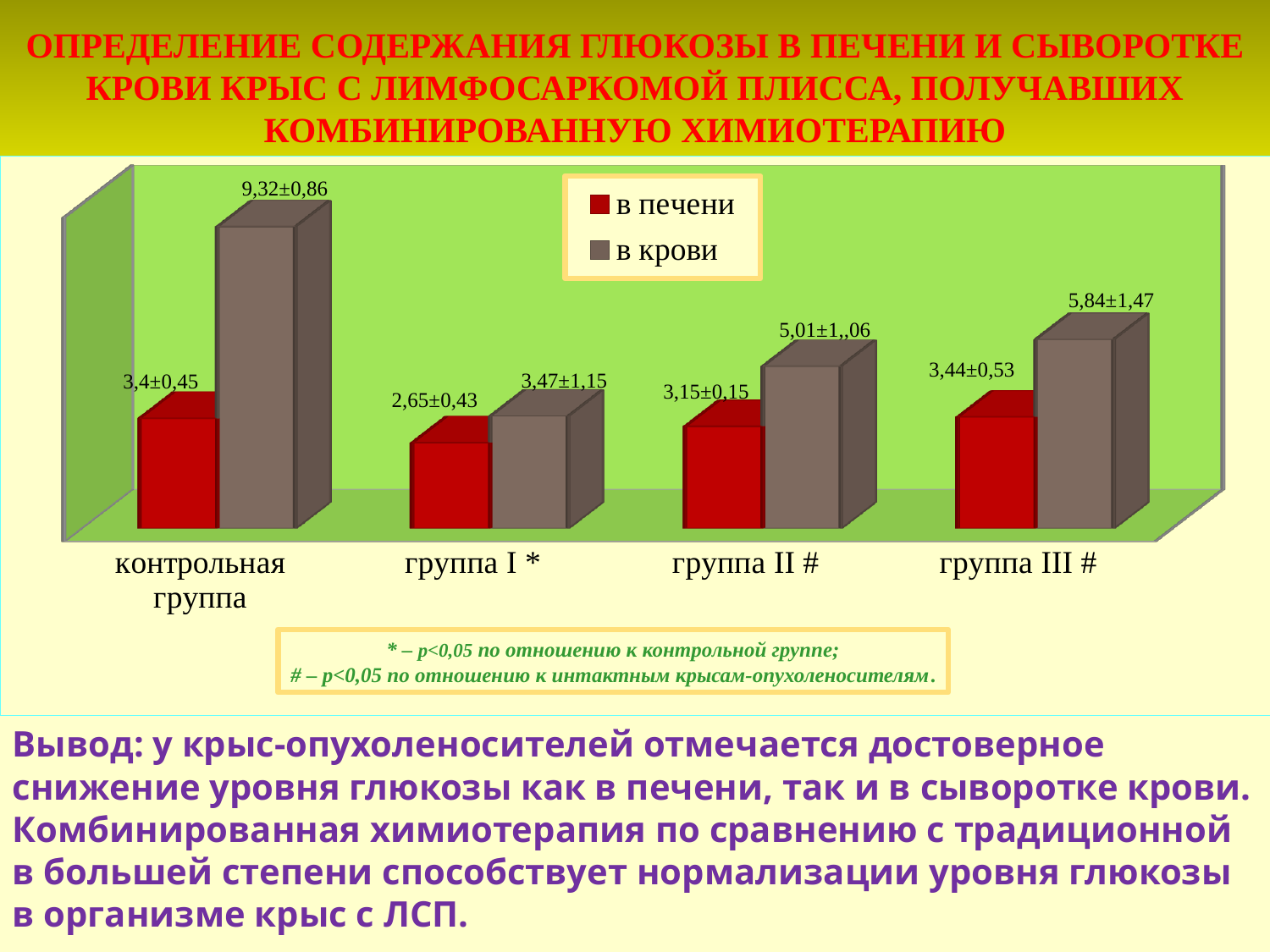
Which category has the lowest value for 'в крови'? группа I * What is the value for 'в крови' in the 'контрольная группа' category? 9,32±0,86 In the 'контрольная группа' category, which is larger: 'в печени' or 'в крови'? в крови What is the value for 'в крови' in the 'группа II #' category? 5,01±1,,06 How many series does the legend list? 2 What is the value for 'в крови' in the 'группа III #' category? 5,84±1,47 Which category has the lowest value for 'в печени'? группа I * What kind of chart is shown on the slide? bar chart What is the value for 'в печени' in the 'группа III #' category? 3,44±0,53 How many categories are shown on the chart? 4 Which category has the highest value for 'в крови'? контрольная группа What is the value for 'в печени' in the 'группа I *' category? 2,65±0,43